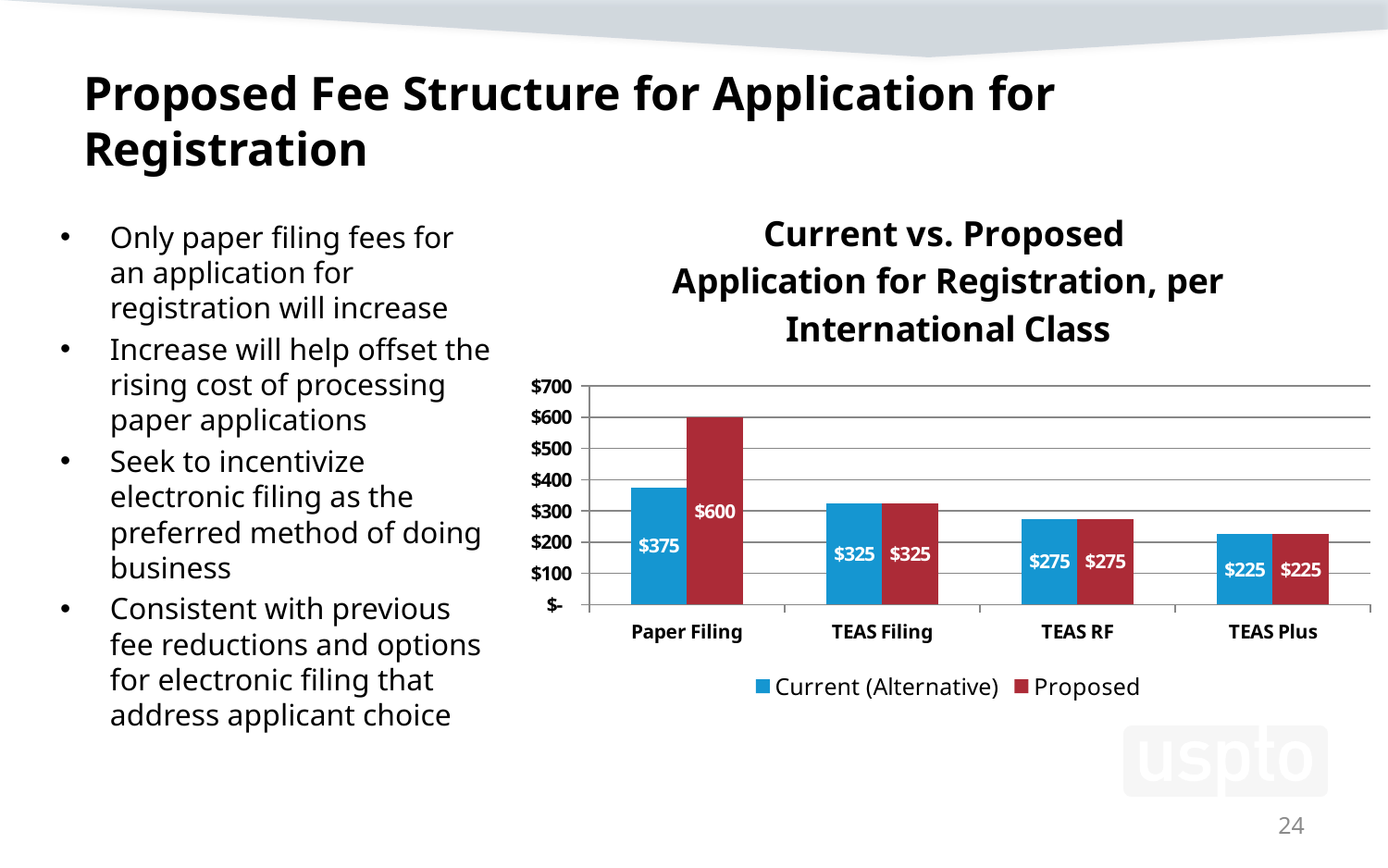
What kind of chart is shown on the slide? Bar chart Which is larger for TEAS Filing: the Current (Alternative) fee or the Proposed fee? They are equal ($325) What is the Current (Alternative) fee for Paper Filing? $375 Which category has the lowest Current (Alternative) fee? TEAS Plus What is the title of the chart? Current vs. Proposed Application for Registration, per International Class What is the Proposed fee for TEAS Plus? $225 What is the Proposed fee for Paper Filing? $600 What is the difference between the Proposed and Current (Alternative) fees for Paper Filing? $225 How many series does the legend list? 2 How many categories are shown on the x axis? 4 What is the Current (Alternative) fee for TEAS RF? $275 Which category has the highest Proposed fee? Paper Filing